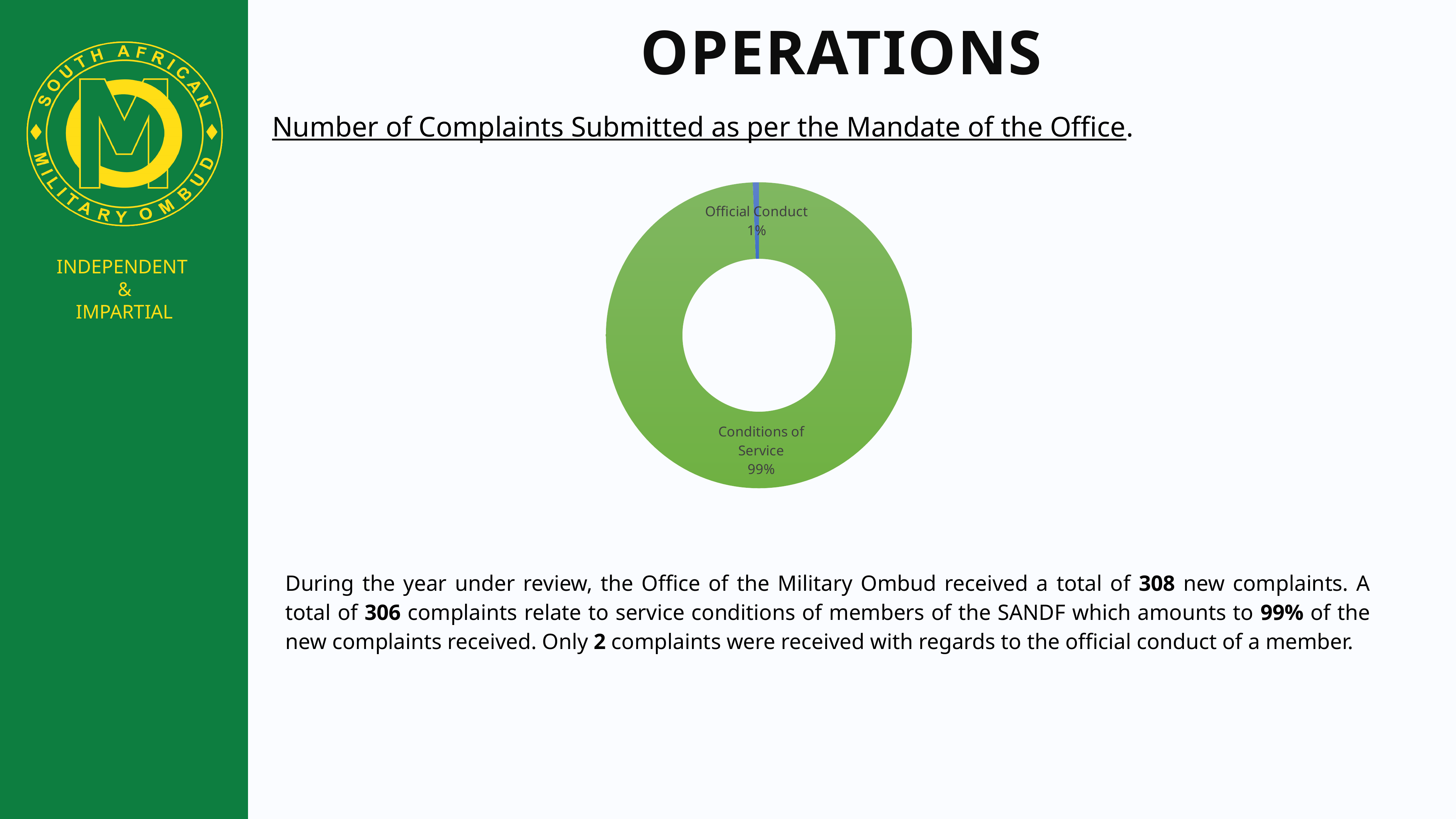
Which category has the smallest share of complaints? Official Conduct What share of complaints does the Conditions of Service slice represent? 99% What colour is the Conditions of Service slice? Green What is the difference in percentage points between the Conditions of Service share and the Official Conduct share? 98 percentage points Which category has the largest share of complaints? Conditions of Service What colour is the Official Conduct slice? Blue Which is larger, the share for Conditions of Service or the share for Official Conduct? Conditions of Service How many categories are shown in the chart? 2 What share of complaints does the Official Conduct slice represent? 1% What kind of chart is shown on the slide? Doughnut (pie) chart